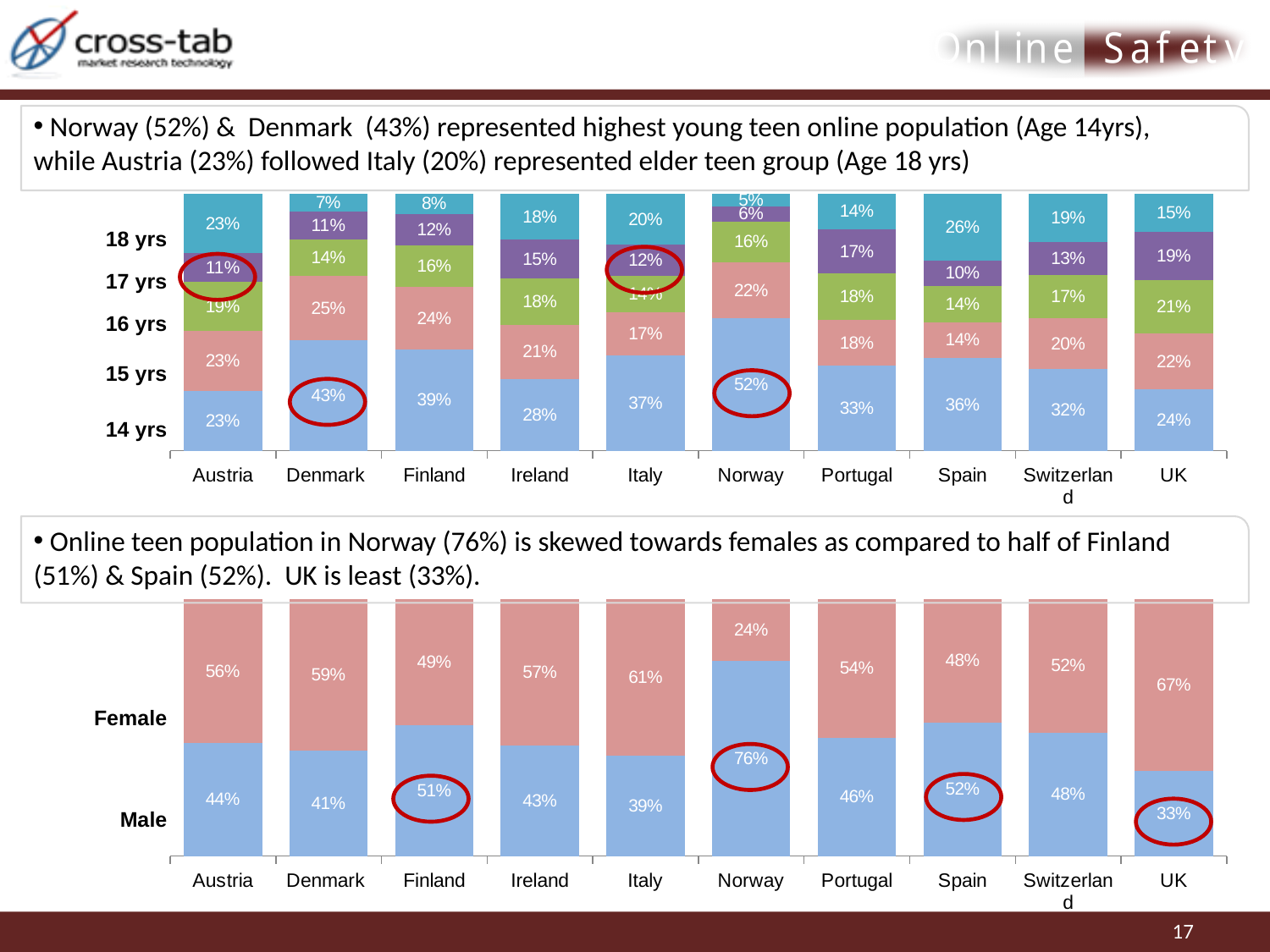
What kind of chart is the bottom chart? Stacked bar chart In the top chart, which country has the highest 14 yrs value? Norway How many countries are shown on the x axis of the top chart? 10 How many age groups are labelled on the top chart? 5 In the top chart, which country has the lowest 14 yrs value? Austria In the top chart, what is the value of the 18 yrs segment for Spain? 26% In the top chart, what is the difference between the 14 yrs values for Denmark and Finland? 4 percentage points In the bottom chart, which country has the lowest blue (lower) segment value? UK In the top chart, what is the value of the 14 yrs segment for Norway? 52% In the top chart, which is larger: the 18 yrs value for Spain or for Austria? Spain In the bottom chart, what is the value of the pink (upper) segment for the UK? 67% In the bottom chart, what is the value of the blue (lower) segment for Norway? 76%